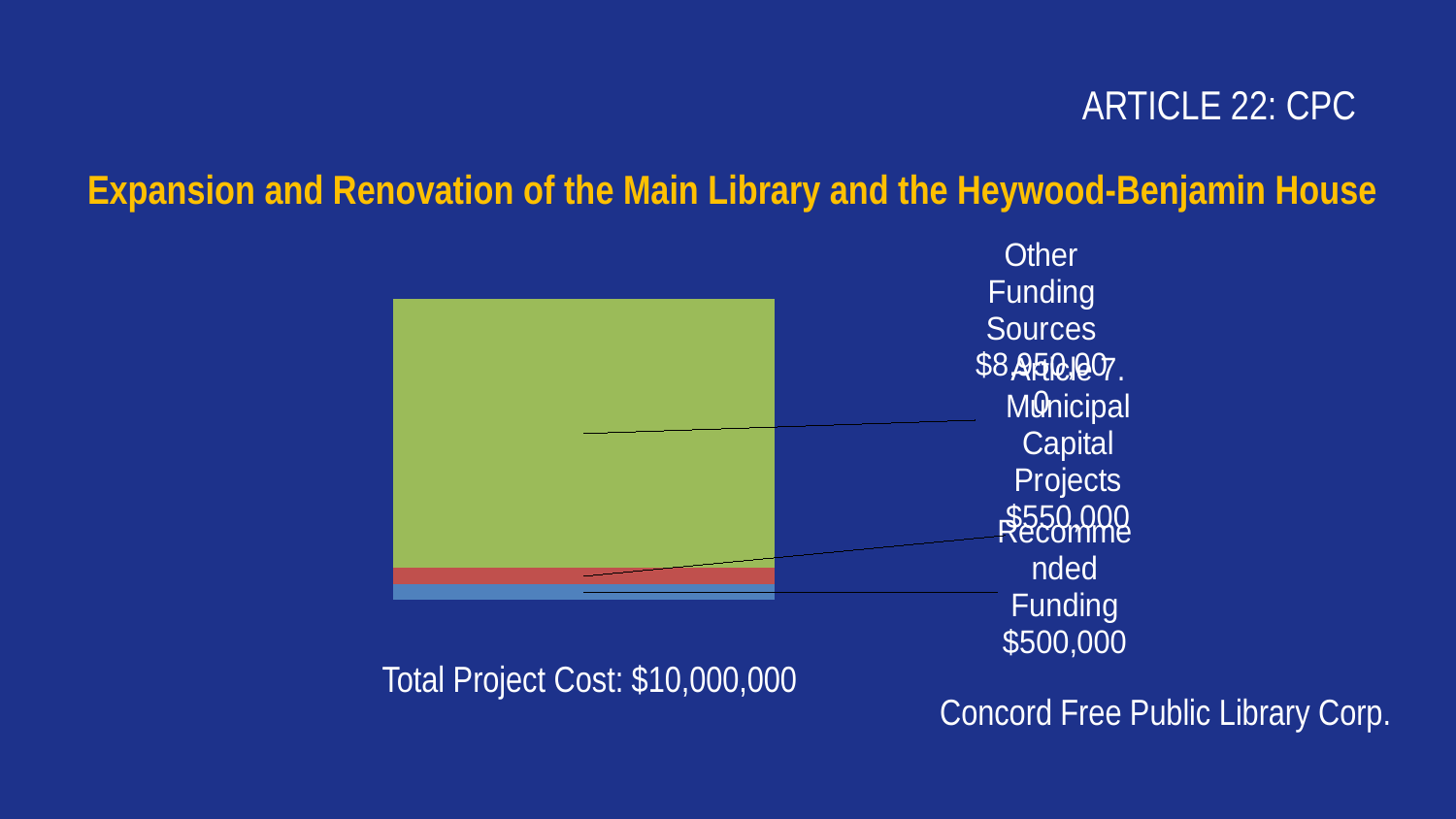
What kind of chart is shown on the slide? Stacked bar chart What is the total project cost shown for the stacked bar? $10,000,000 What is the title of the project shown on the slide? Expansion and Renovation of the Main Library and the Heywood-Benjamin House Which funding segment is the largest? Other Funding Sources What is the difference between Article 7. Municipal Capital Projects and Recommended Funding? $50,000 Which funding segment is the smallest? Recommended Funding How many segments make up the stacked bar? 3 What is the value for Article 7. Municipal Capital Projects? $550,000 What is the value for Recommended Funding? $500,000 What colour is the largest segment of the bar? Green Which is larger, Article 7. Municipal Capital Projects or Recommended Funding? Article 7. Municipal Capital Projects